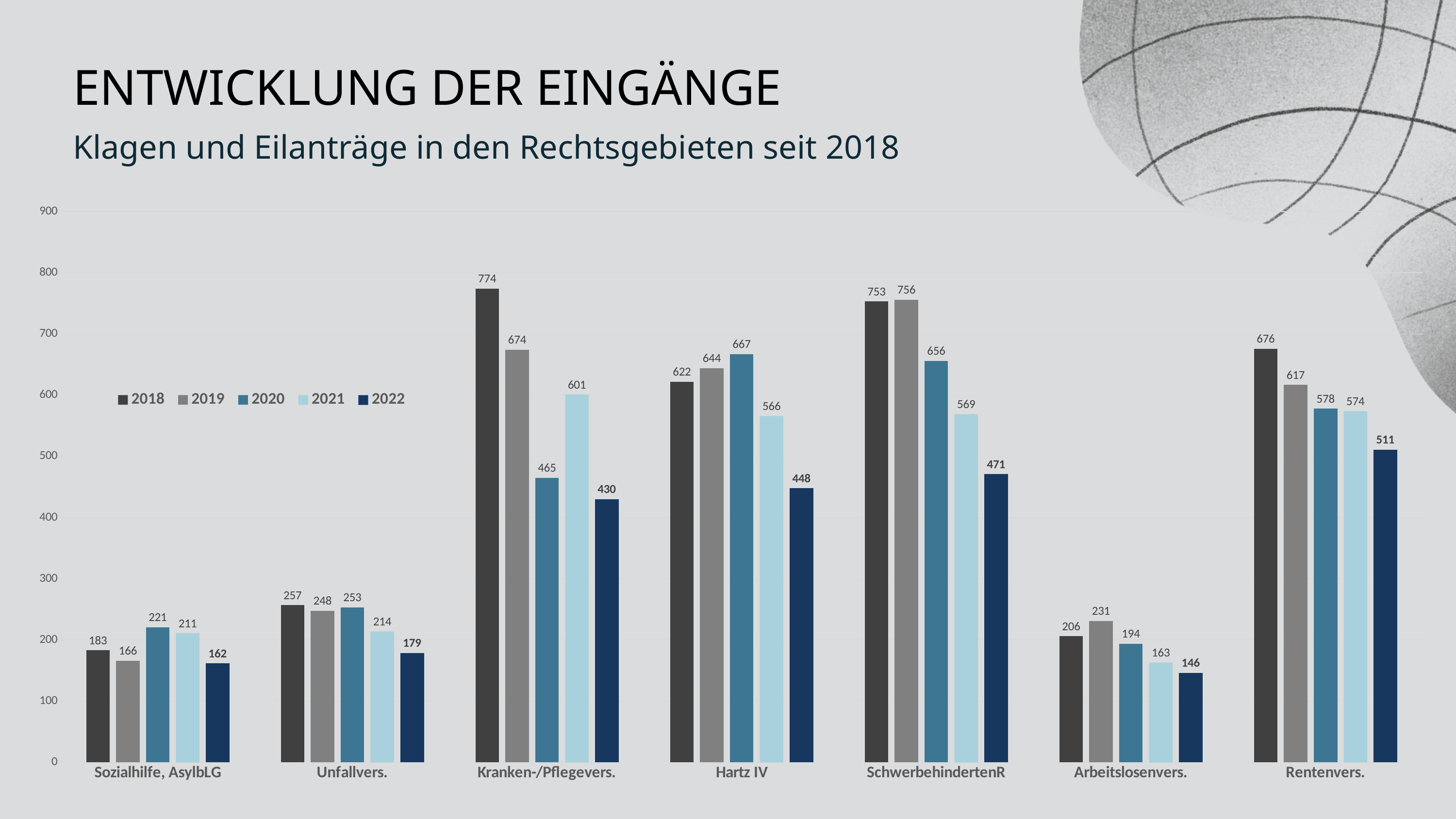
What is the value for Arbeitslosenvers. in 2019? 231 What is the value for Hartz IV in 2020? 667 Which category has the lowest value in 2022? Arbeitslosenvers. Which is larger: the 2021 value for Hartz IV or the 2021 value for SchwerbehindertenR? SchwerbehindertenR What is the subtitle of the chart on the slide? Klagen und Eilanträge in den Rechtsgebieten seit 2018 How many series does the legend list? 5 What is the value for Rentenvers. in 2022? 511 What kind of chart is shown on the slide? Bar chart How many categories are shown on the x axis? 7 Which category has the highest value in 2018? Kranken-/Pflegevers. What is the difference between the 2018 and 2022 values for Kranken-/Pflegevers.? 344 Do the values for Arbeitslosenvers. rise or fall from 2019 to 2022? Fall